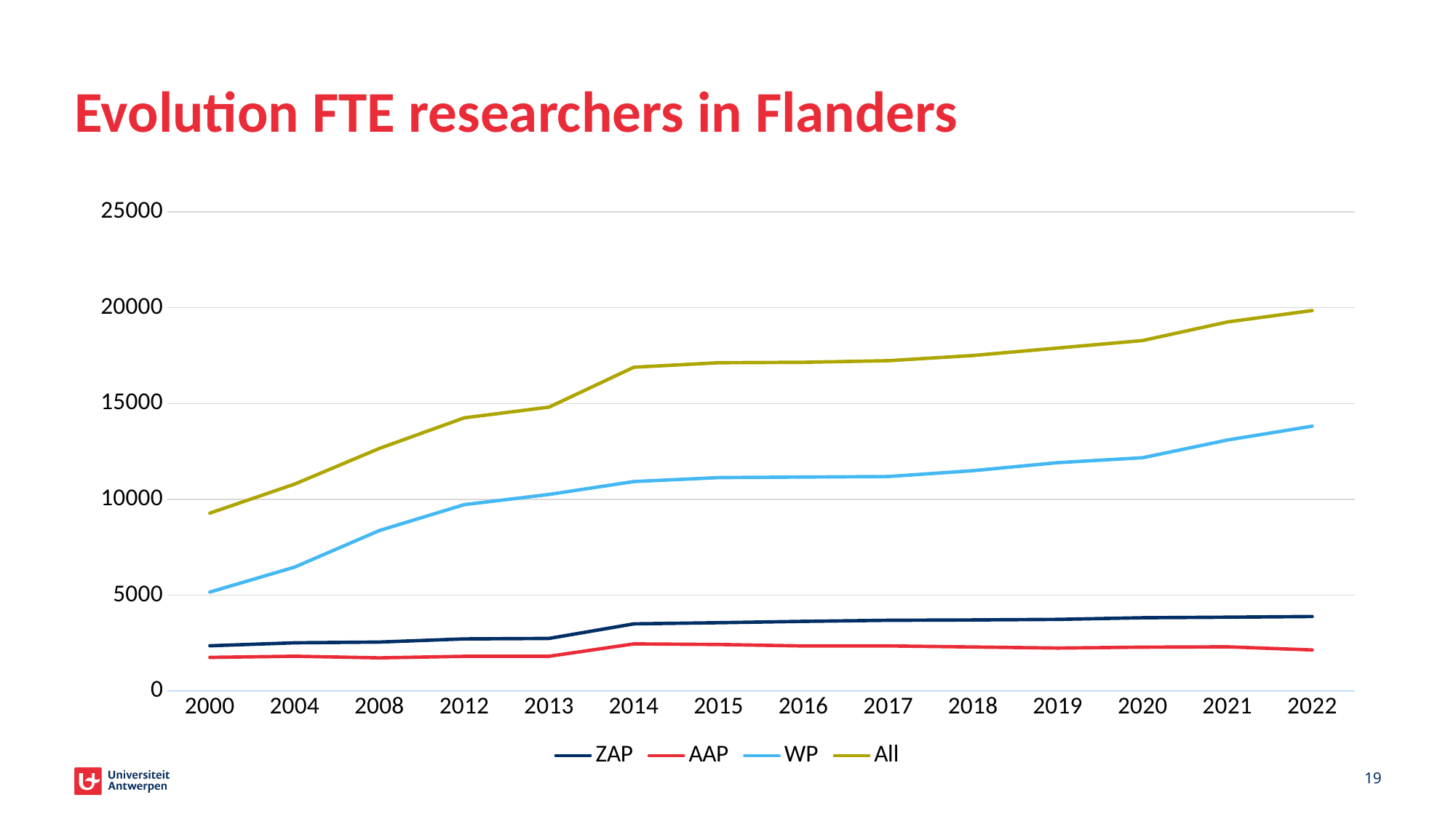
Which series has the highest value in 2022? All Which is larger in 2022, the value for WP or the value for ZAP? WP Is the value for ZAP in 2022 greater or less than 5000? less What kind of chart is shown on the slide? line chart Is the value for All in 2014 greater or less than 15000? greater What is the title of the chart? Evolution FTE researchers in Flanders Does the All series rise or fall from 2000 to 2022? rise Is the value for All in 2022 greater or less than 15000? greater How many series does the legend list? 4 Which series has the lowest value in 2022? AAP How many years are shown along the x axis? 14